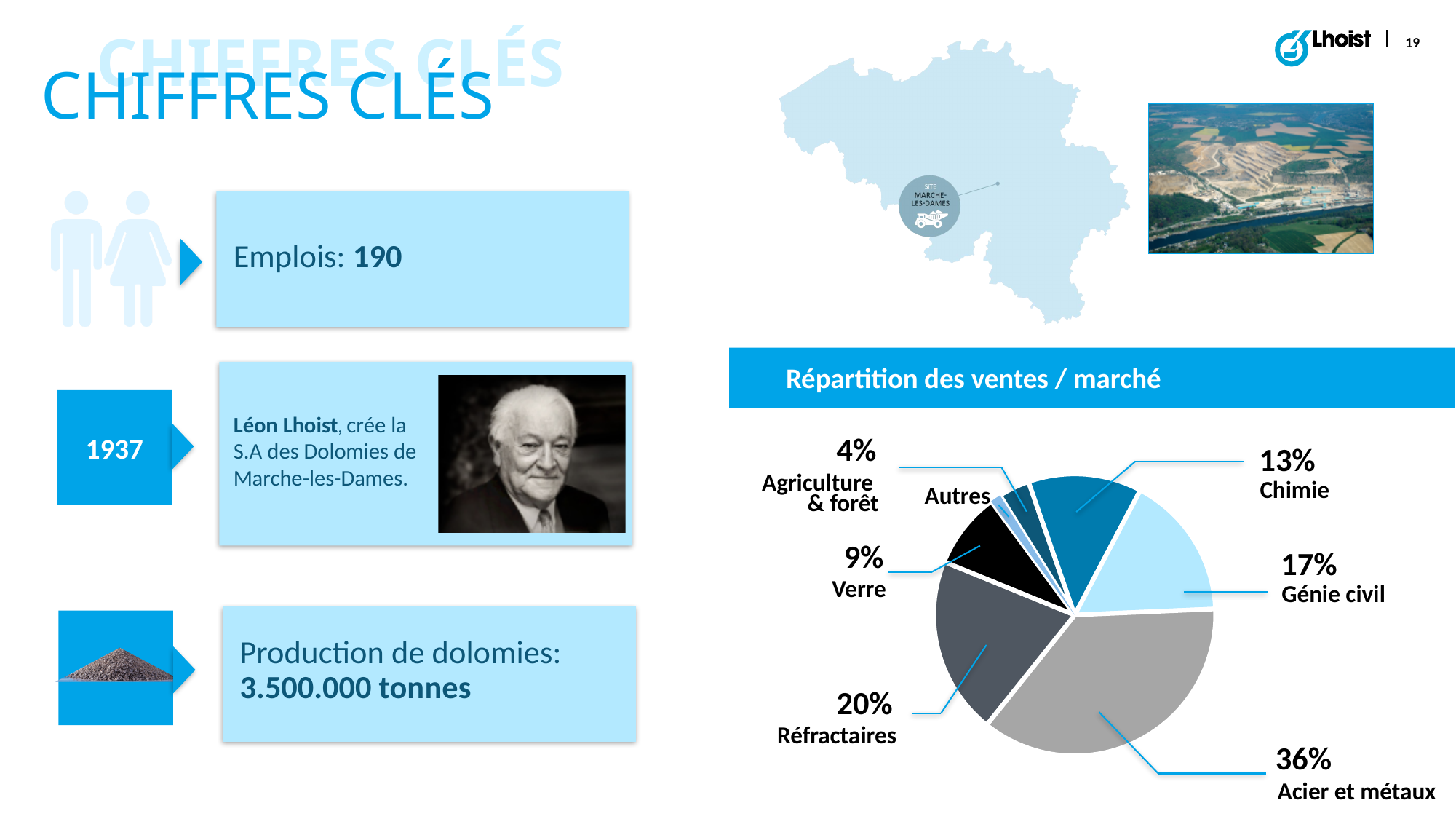
What share of sales does "Acier et métaux" represent in the pie chart? 36% Which market has the largest share in the pie chart? Acier et métaux What kind of chart is shown under the title "Répartition des ventes / marché"? Pie chart What percentage is shown for "Réfractaires" in the pie chart? 20% Which has a larger share in the pie chart, "Génie civil" or "Chimie"? Génie civil What percentage is shown for "Agriculture & forêt" in the pie chart? 4% What percentage is shown for "Chimie" in the pie chart? 13% What is the difference in percentage points between "Acier et métaux" and "Réfractaires" in the pie chart? 16 What percentage is shown for "Verre" in the pie chart? 9% Which of the labelled markets with a printed percentage has the smallest share in the pie chart? Agriculture & forêt How many slices does the pie chart have? 7 What percentage is shown for "Génie civil" in the pie chart? 17%